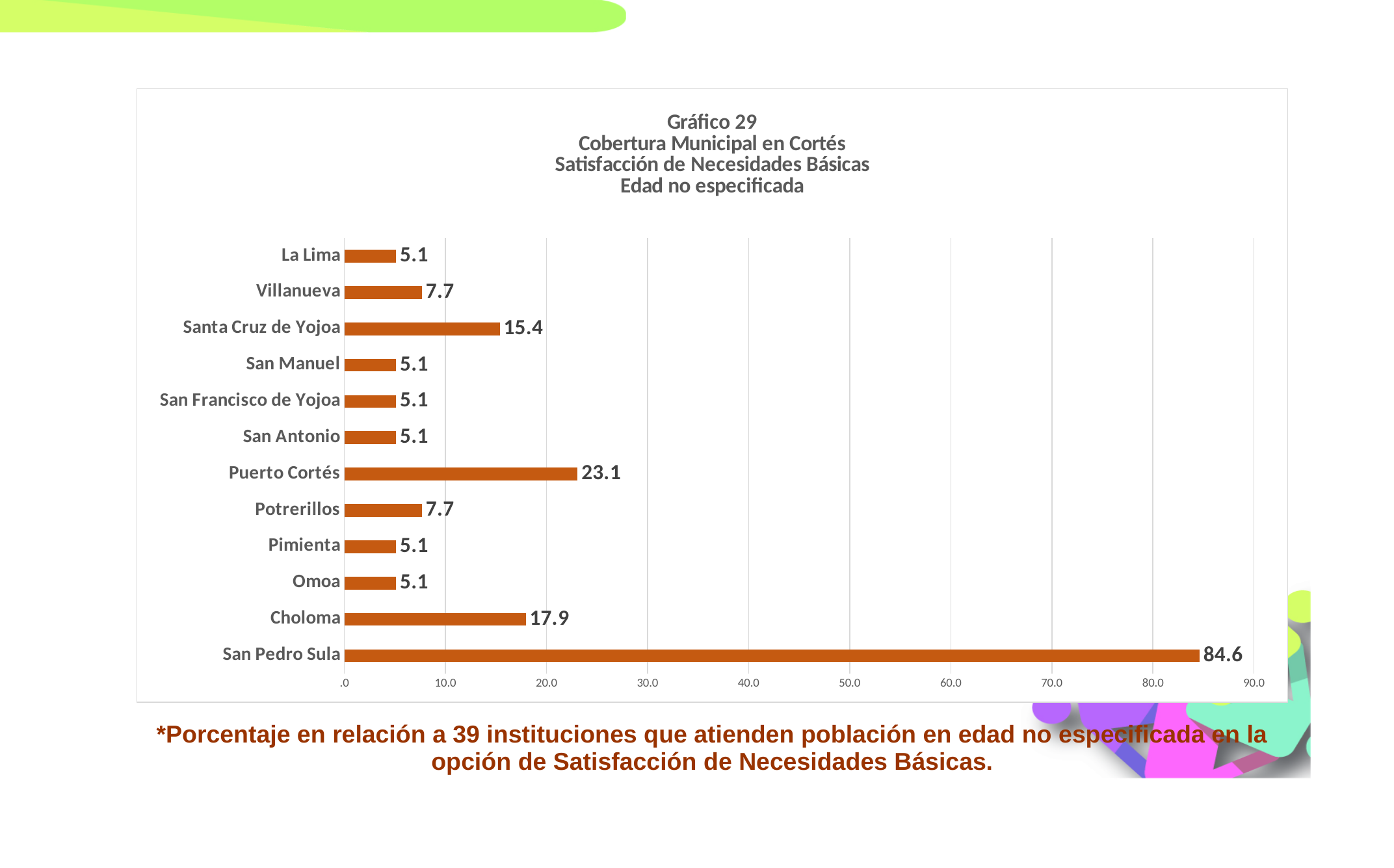
What is the value for Santa Cruz de Yojoa? 15.4 Is the value for San Pedro Sula greater or less than 80.0? greater What is the value for San Pedro Sula? 84.6 How many municipalities are shown in the chart? 12 What is the value for Choloma? 17.9 What is the number of the chart given in its title? Gráfico 29 What kind of chart is shown on the slide? Bar chart What is the difference between the values for San Pedro Sula and Puerto Cortés? 61.5 What is the value for Puerto Cortés? 23.1 Which is larger, the value for Villanueva or the value for Santa Cruz de Yojoa? Santa Cruz de Yojoa What is the difference between the values for Choloma and Santa Cruz de Yojoa? 2.5 Which municipality has the highest value? San Pedro Sula